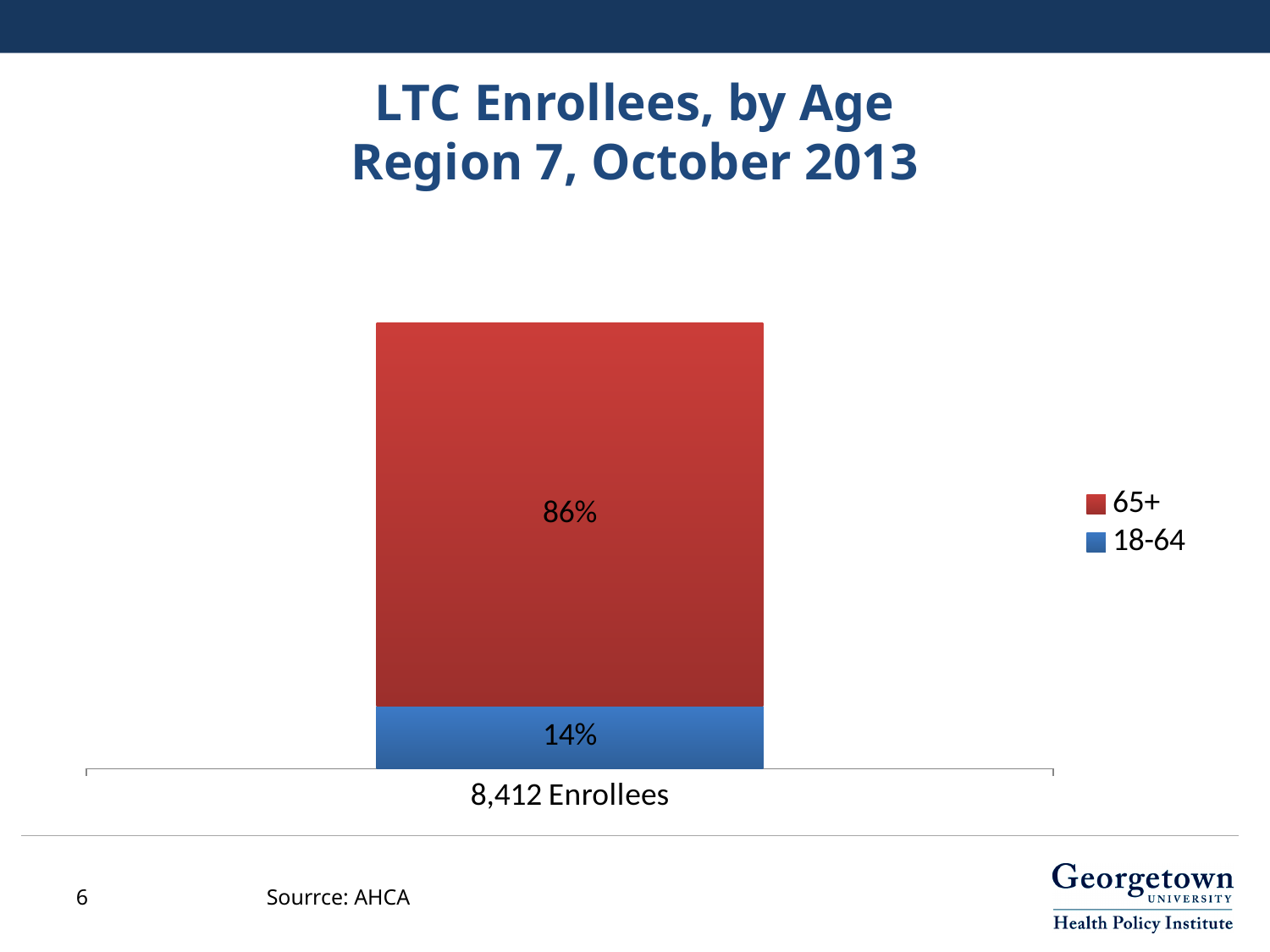
Is the share for 65+ larger or smaller than the share for 18-64? larger What percentage of LTC enrollees are aged 18-64? 14% Which colour represents the 18-64 age group? blue How many series does the legend list? 2 What is the label under the bar on the x axis? 8,412 Enrollees Which age group has the smaller share of LTC enrollees? 18-64 Which age group has the larger share of LTC enrollees? 65+ What is the total of the two segments in the stacked bar? 100% What kind of chart is shown on the slide? stacked bar chart What percentage of LTC enrollees are aged 65+? 86% How many bars are plotted in the chart? 1 What is the difference in percentage points between the 65+ share and the 18-64 share? 72